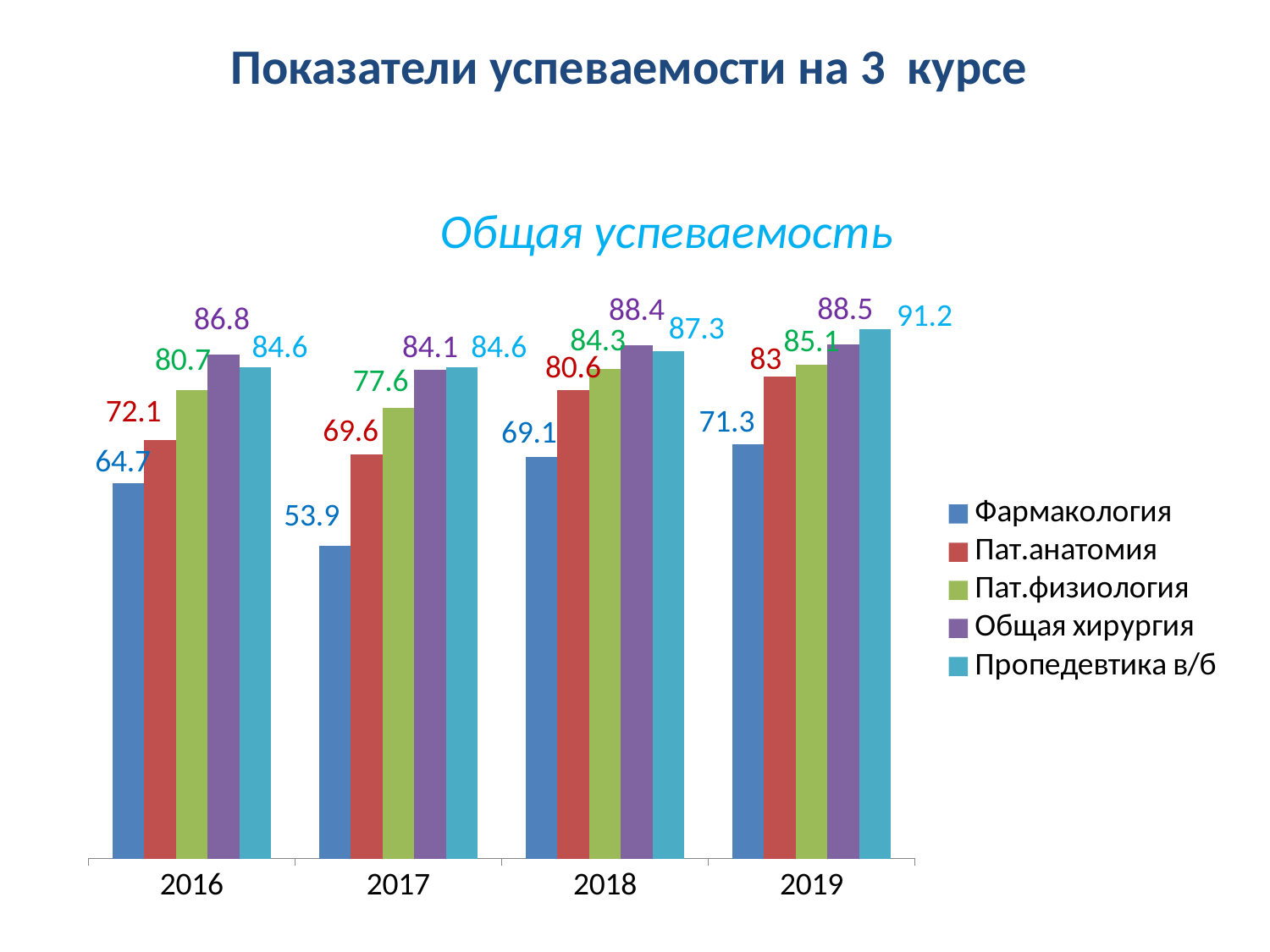
Which is larger in 2018: the value for Общая хирургия or the value for Пропедевтика в/б? Общая хирургия Which series has the highest value in 2019? Пропедевтика в/б What is the difference between the Пат.физиология values in 2019 and 2016? 4.4 What is the value for Пропедевтика в/б in 2019? 91.2 Does the value for Пат.анатомия rise or fall from 2017 to 2019? Rise Which year has the lowest value for Фармакология? 2017 What is the value for Фармакология in 2017? 53.9 How many series does the legend list? 5 What is the value for Общая хирургия in 2016? 86.8 What kind of chart is shown on the slide? Bar chart What is the value for Пат.анатомия in 2018? 80.6 How many years are shown on the x axis? 4